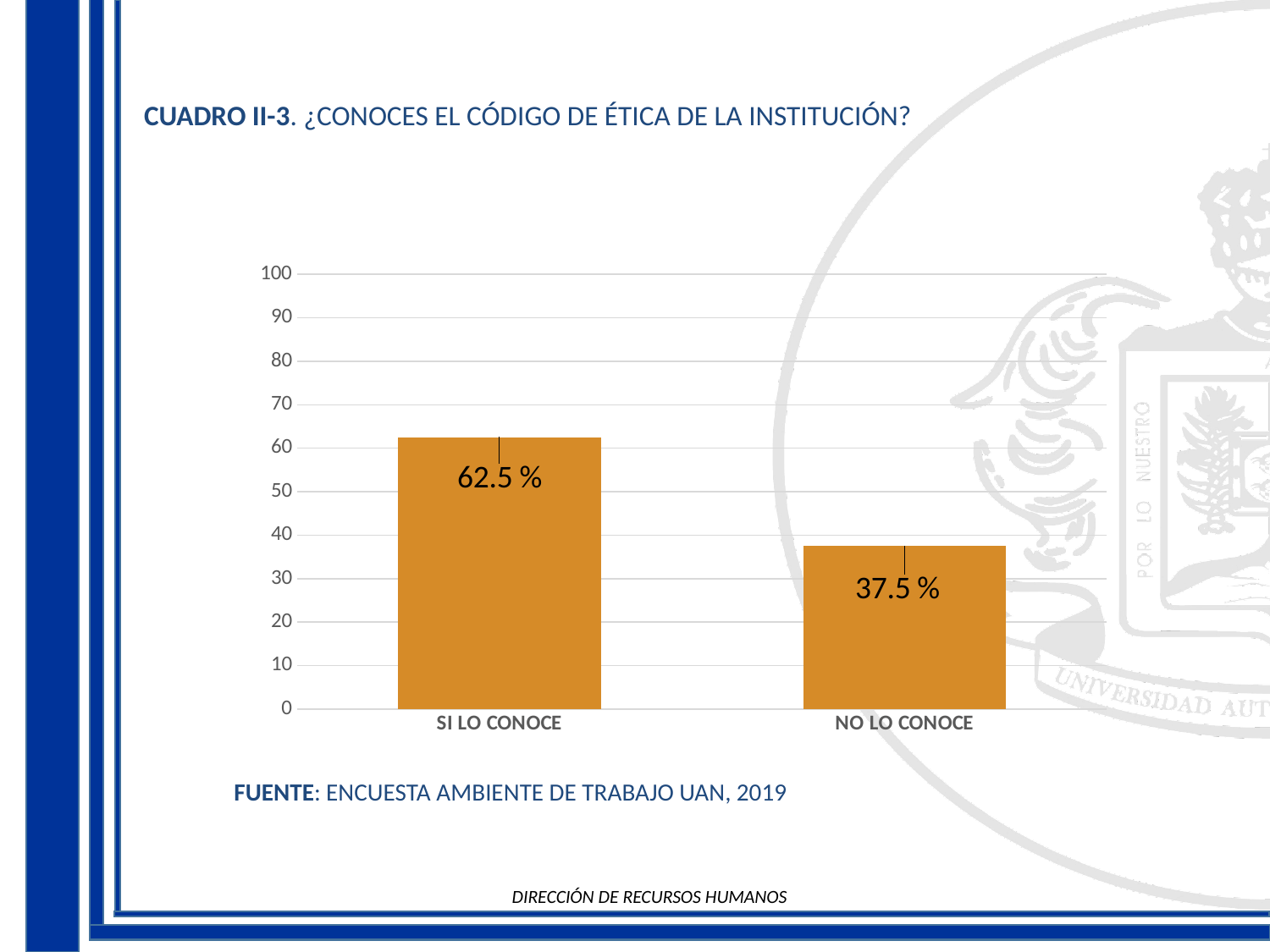
Which is larger, the value for SI LO CONOCE or the value for NO LO CONOCE? SI LO CONOCE What is the difference between the values for SI LO CONOCE and NO LO CONOCE? 25 % What is the value for NO LO CONOCE? 37.5 % What is the total of the two values shown on the chart? 100 % How many categories are shown on the chart? 2 Which category has the highest value? SI LO CONOCE What kind of chart is shown on the slide? bar chart Is the value for SI LO CONOCE greater or less than 50? greater What is the value for SI LO CONOCE? 62.5 % Which category has the lowest value? NO LO CONOCE Is the value for NO LO CONOCE greater or less than 40? less What is the source cited below the chart? ENCUESTA AMBIENTE DE TRABAJO UAN, 2019